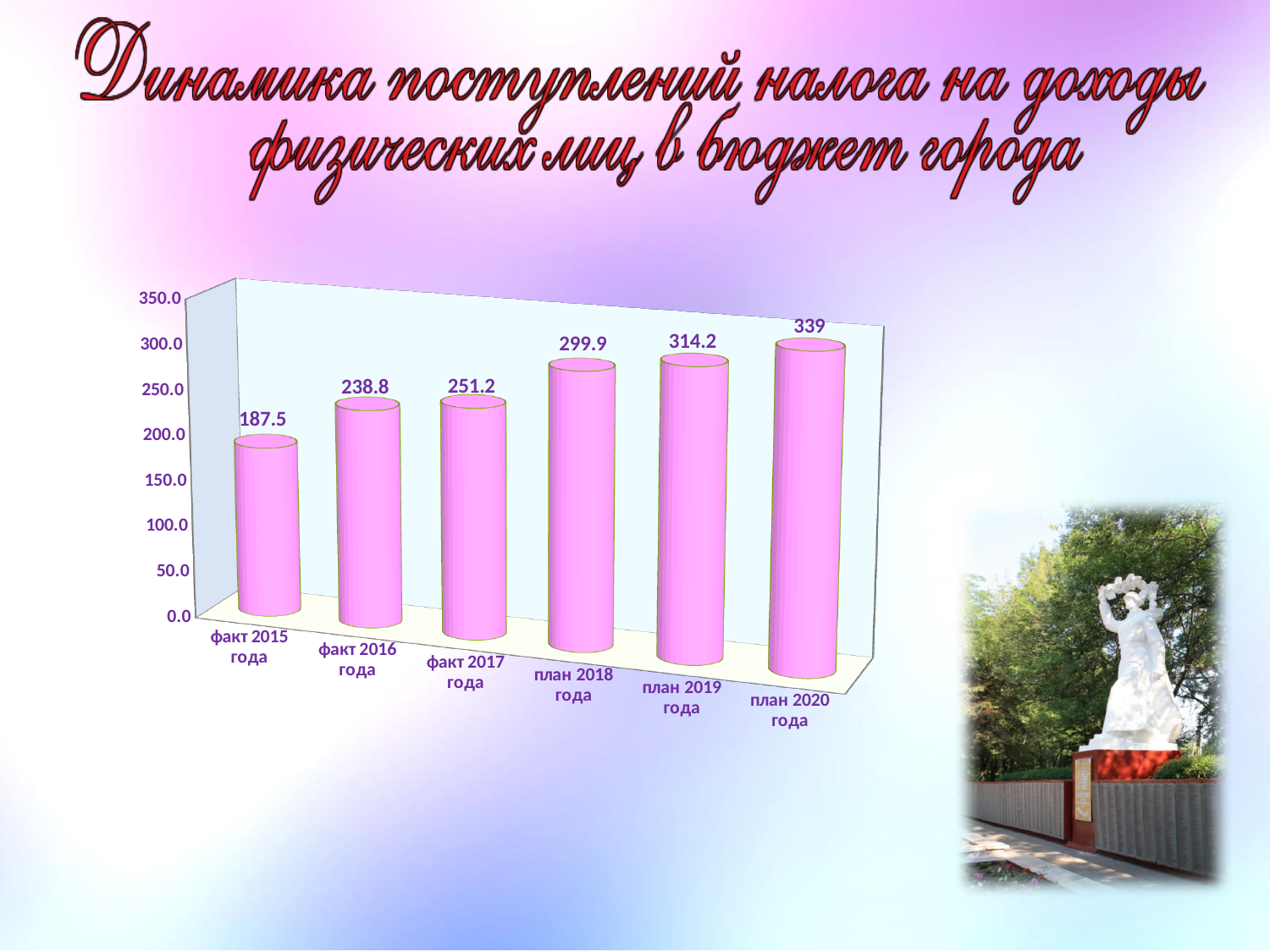
What kind of chart is shown on the slide? bar chart How many categories are shown on the chart? 6 Do the values rise or fall from факт 2015 года to план 2020 года? rise What is the value for план 2020 года? 339 Which category has the highest value? план 2020 года Which category has the lowest value? факт 2015 года What is the value for план 2018 года? 299.9 What is the value for факт 2015 года? 187.5 What is the difference between the values for факт 2016 года and факт 2015 года? 51.3 Which is larger, the value for факт 2017 года or the value for план 2018 года? план 2018 года Is the value for план 2019 года greater or less than 300.0? greater What is the difference between the values for план 2019 года and факт 2017 года? 63